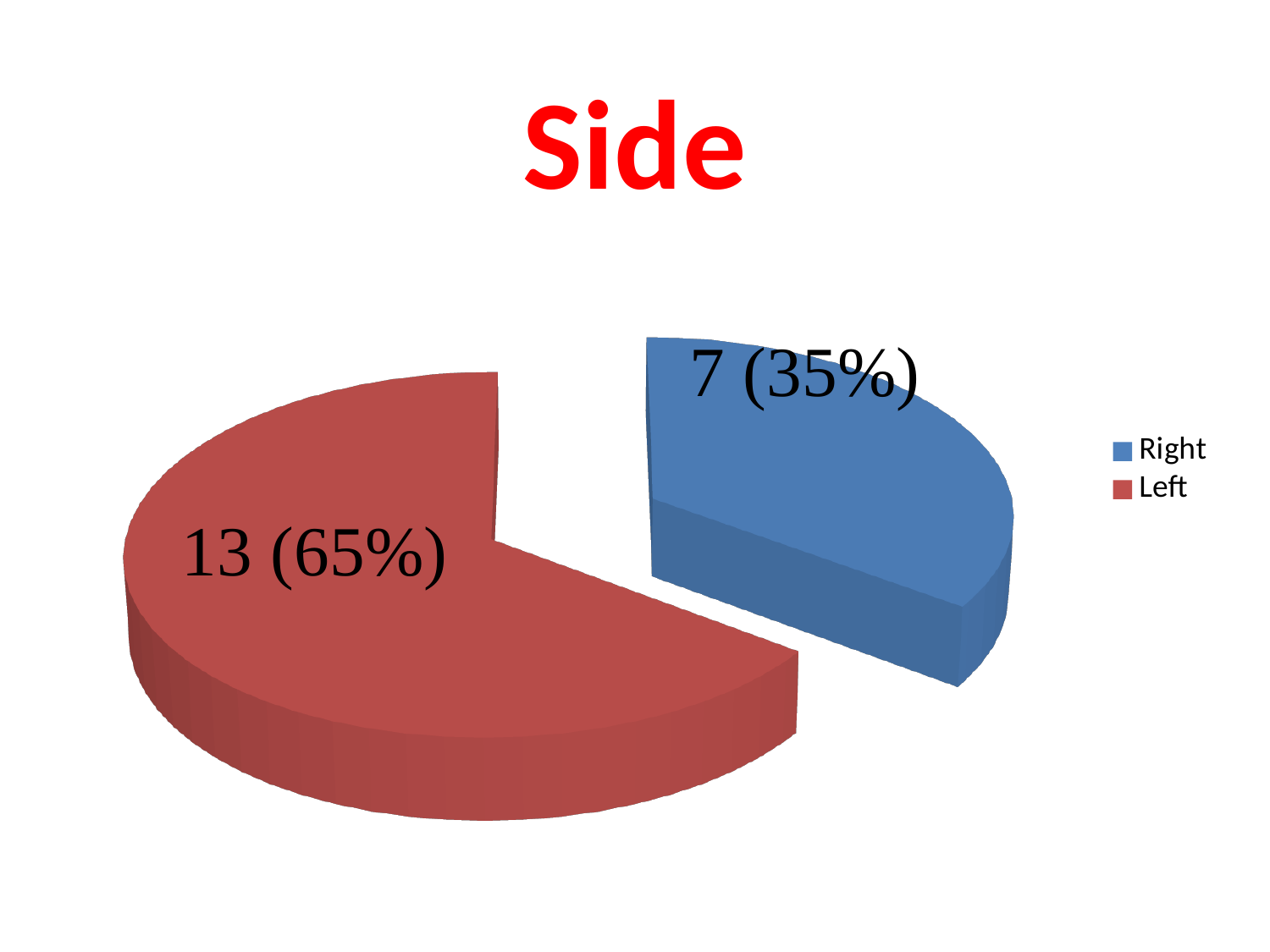
What is the count shown for the Right slice? 7 How many slices does the pie chart have? 2 Which slice is the smallest? Right How many entries does the legend list? 2 What share of the pie does the Right slice represent? 35% What kind of chart is shown on the slide? pie chart What is the difference between the counts for Left and Right? 6 What is the title of the chart? Side What share of the pie does the Left slice represent? 65% What is the count shown for the Left slice? 13 Which colour represents the Right slice in the legend? blue Which slice is the largest? Left